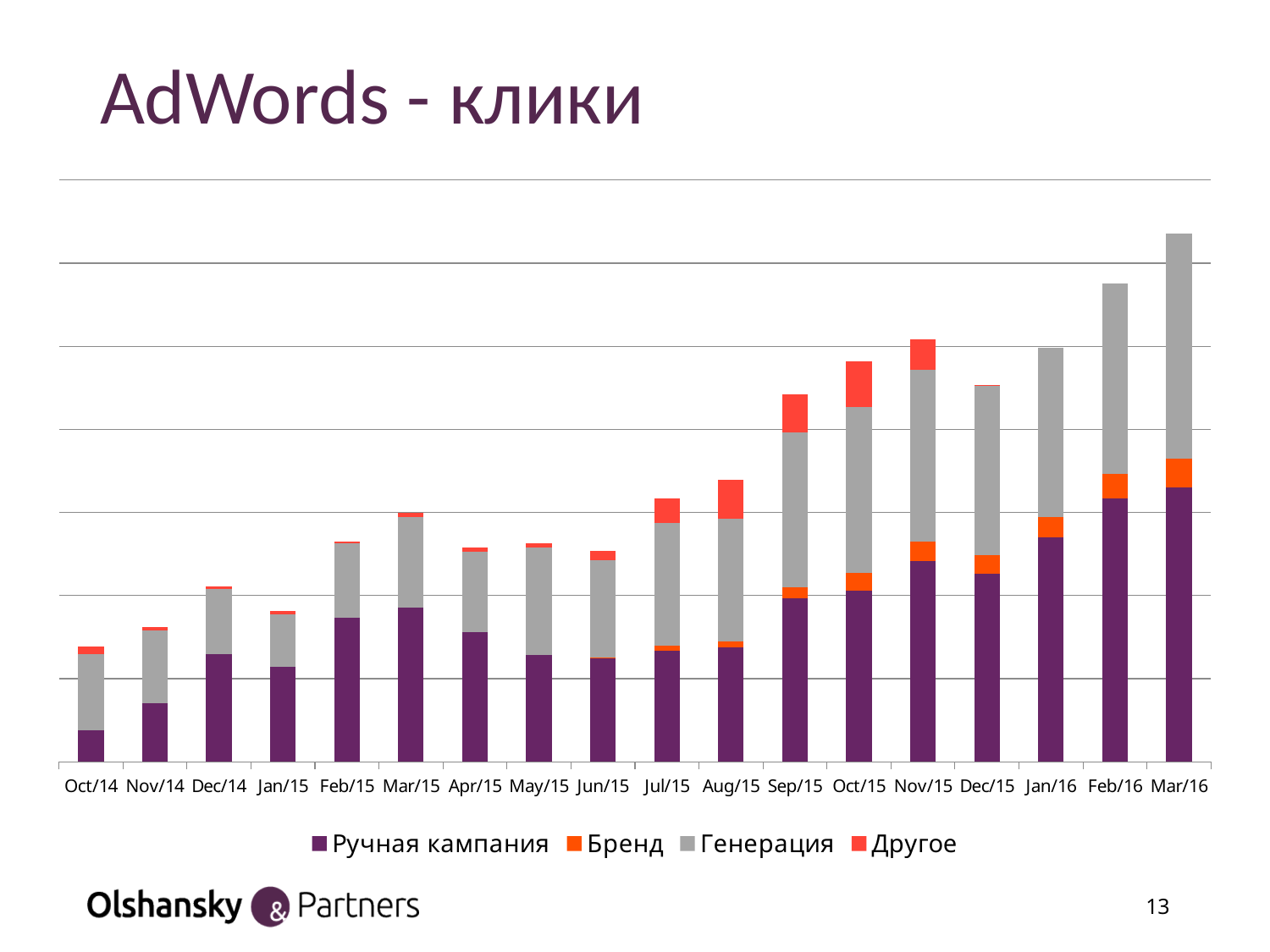
Which stacked bar is taller, Nov/15 or Dec/15? Nov/15 Which month has the largest Ручная кампания segment? Mar/16 How many months are shown along the x axis? 18 Which series is shown in grey in the legend? Генерация Which month has the shortest stacked bar overall? Oct/14 Do the total clicks generally rise or fall from Oct/14 to Mar/16? Rise What kind of chart is shown on the slide? Stacked bar chart Which stacked bar is taller, Dec/14 or Jan/15? Dec/14 What is the title of the slide's chart? AdWords - клики Which month has the tallest stacked bar overall? Mar/16 How many series does the legend list? 4 Which month has the smallest Ручная кампания segment? Oct/14